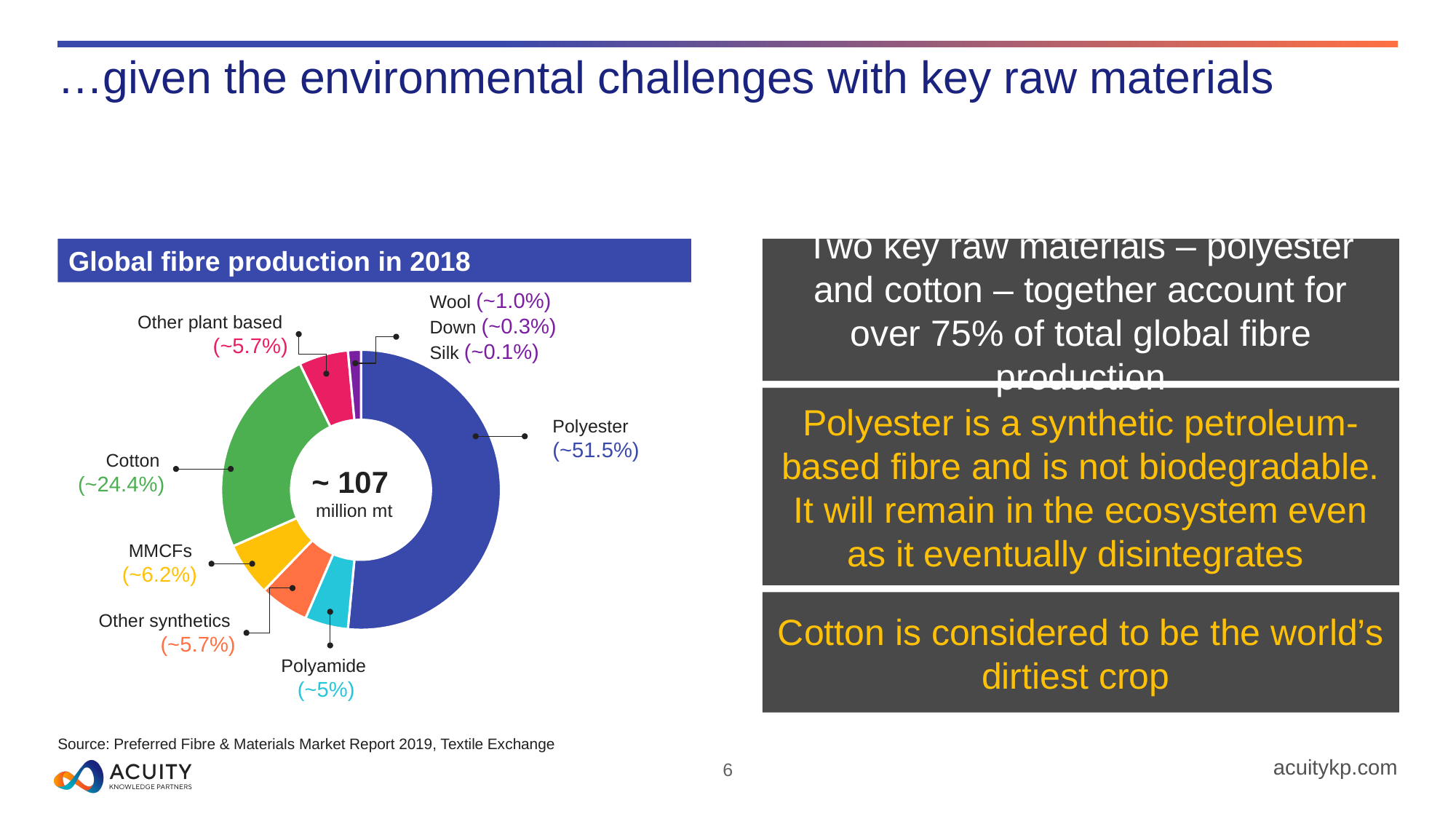
How many fibre categories are shown in the Global fibre production in 2018 chart? 9 What share of global fibre production in 2018 is labelled for Polyester? ~51.5% Which fibre has the smallest share in the Global fibre production in 2018 chart? Silk What share of global fibre production in 2018 is labelled for Cotton? ~24.4% What share is labelled for Polyamide in the Global fibre production in 2018 chart? ~5% What kind of chart is shown under the title "Global fibre production in 2018"? Doughnut chart What share is labelled for MMCFs in the Global fibre production in 2018 chart? ~6.2% In the Global fibre production in 2018 chart, which has the larger share, Cotton or MMCFs? Cotton What total global fibre production figure is shown in the centre of the chart? ~ 107 million mt What share is labelled for Wool in the Global fibre production in 2018 chart? ~1.0% Which fibre has the largest share in the Global fibre production in 2018 chart? Polyester What is the title of the chart on the slide? Global fibre production in 2018